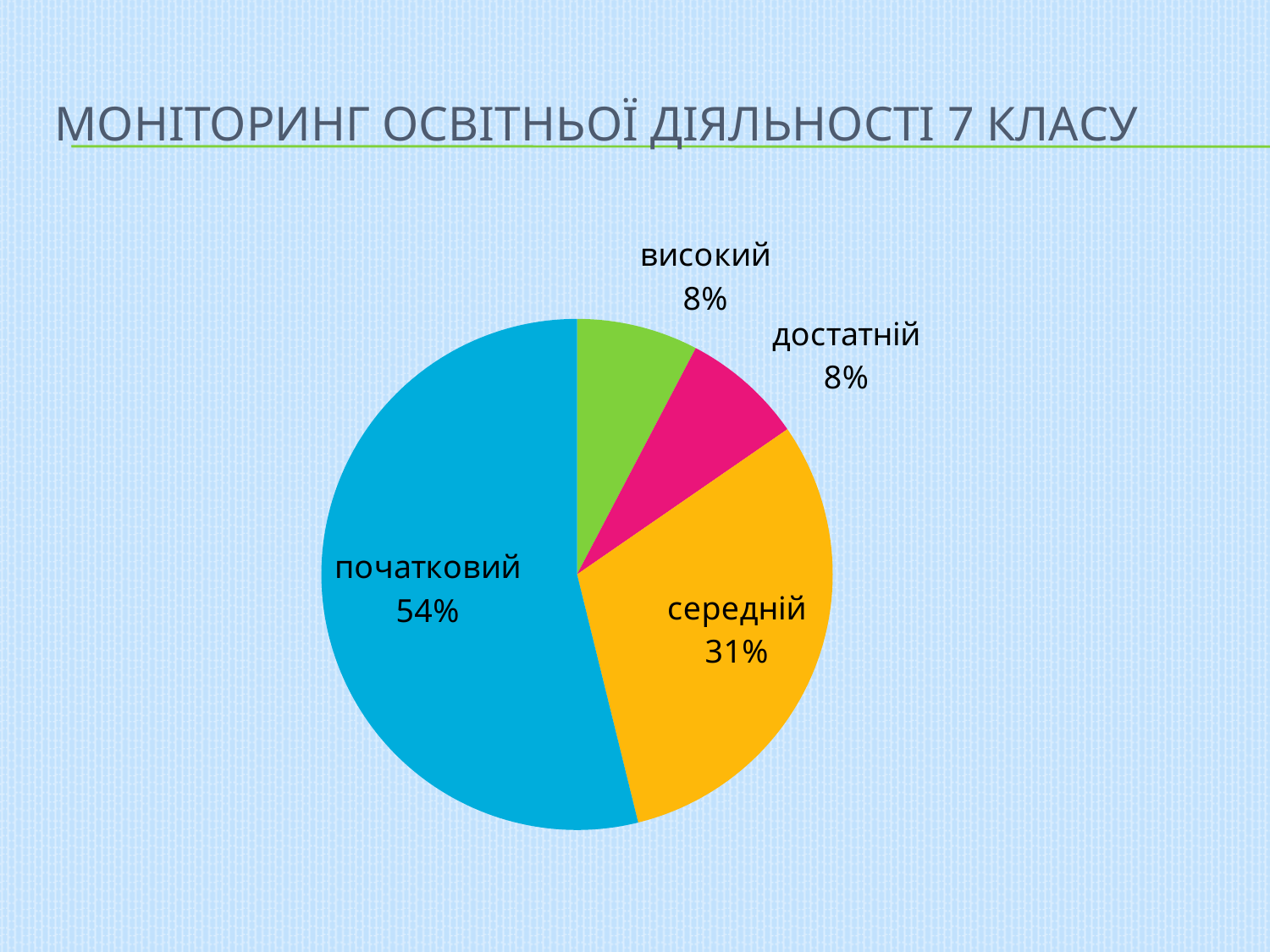
What is the title of the slide containing the chart? МОНІТОРИНГ ОСВІТНЬОЇ ДІЯЛЬНОСТІ 7 КЛАСУ Which category has the largest slice of the pie? початковий What is the difference between the "середній" and "високий" shares? 23% What share of the pie does the "середній" slice represent? 31% What is the value shown for "високий"? 8% What is the difference between the "початковий" and "середній" shares? 23% What is the value shown for "достатній"? 8% Which is larger, the "середній" slice or the "достатній" slice? середній How many slices does the pie chart have? 4 What share of the pie does the "початковий" slice represent? 54% What colour is the "середній" slice? orange What kind of chart is shown on the slide? pie chart